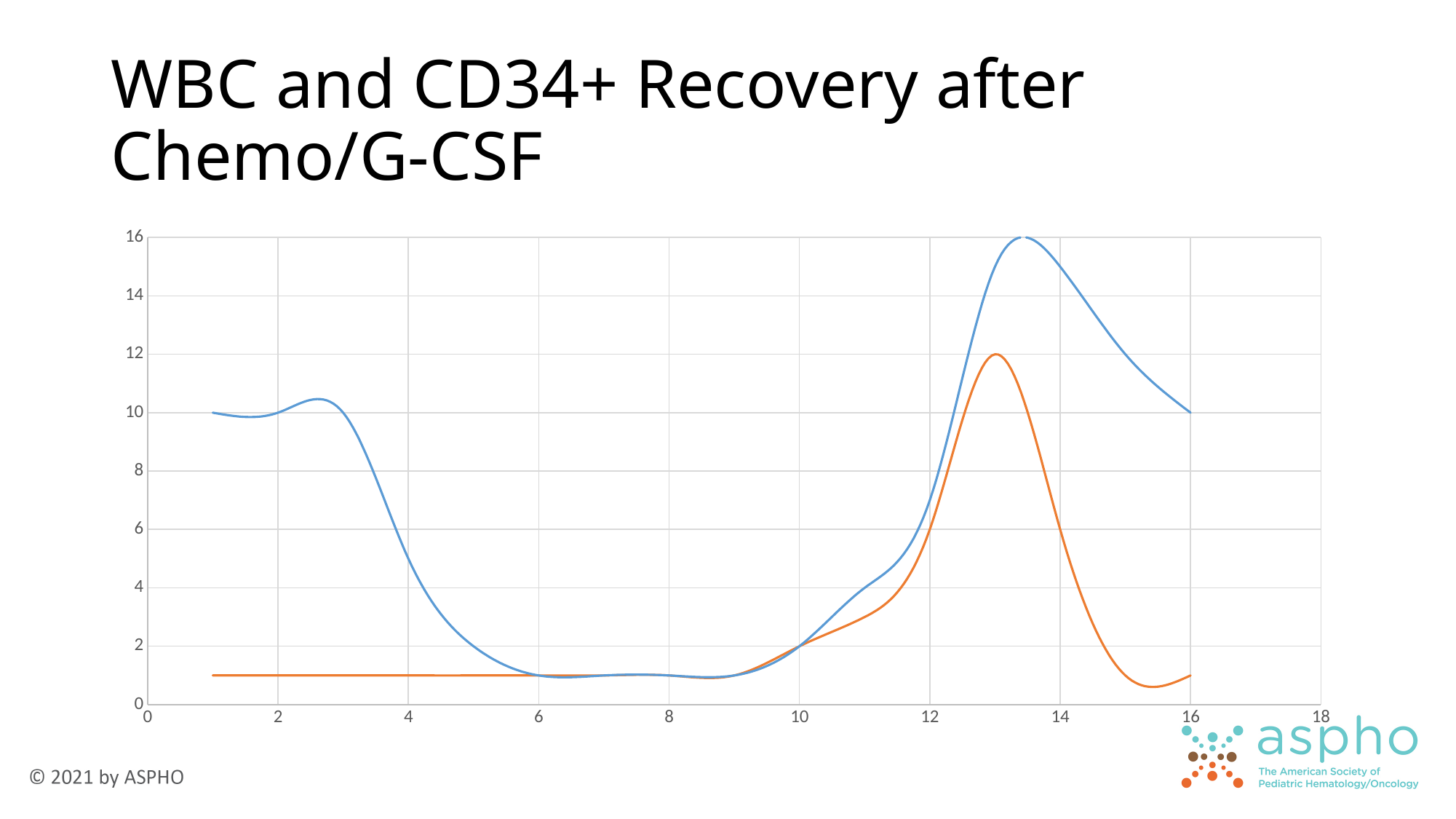
What is the peak value reached by the orange line? 12 Is the value of the orange line at x = 4 greater or less than 2? less At x = 14, which line has the higher value, the blue line or the orange line? blue line How many lines are plotted on the chart? 2 What is the title of the chart on the slide? WBC and CD34+ Recovery after Chemo/G-CSF Does the blue line rise or fall between x = 3 and x = 6? fall Which line reaches the higher peak, the blue line or the orange line? blue line What kind of chart is shown on the slide? line chart Is the value of the blue line at x = 14 greater or less than 14? greater Is the value of the orange line at x = 15 greater or less than 2? less What is the value of the blue line at x = 16? 10